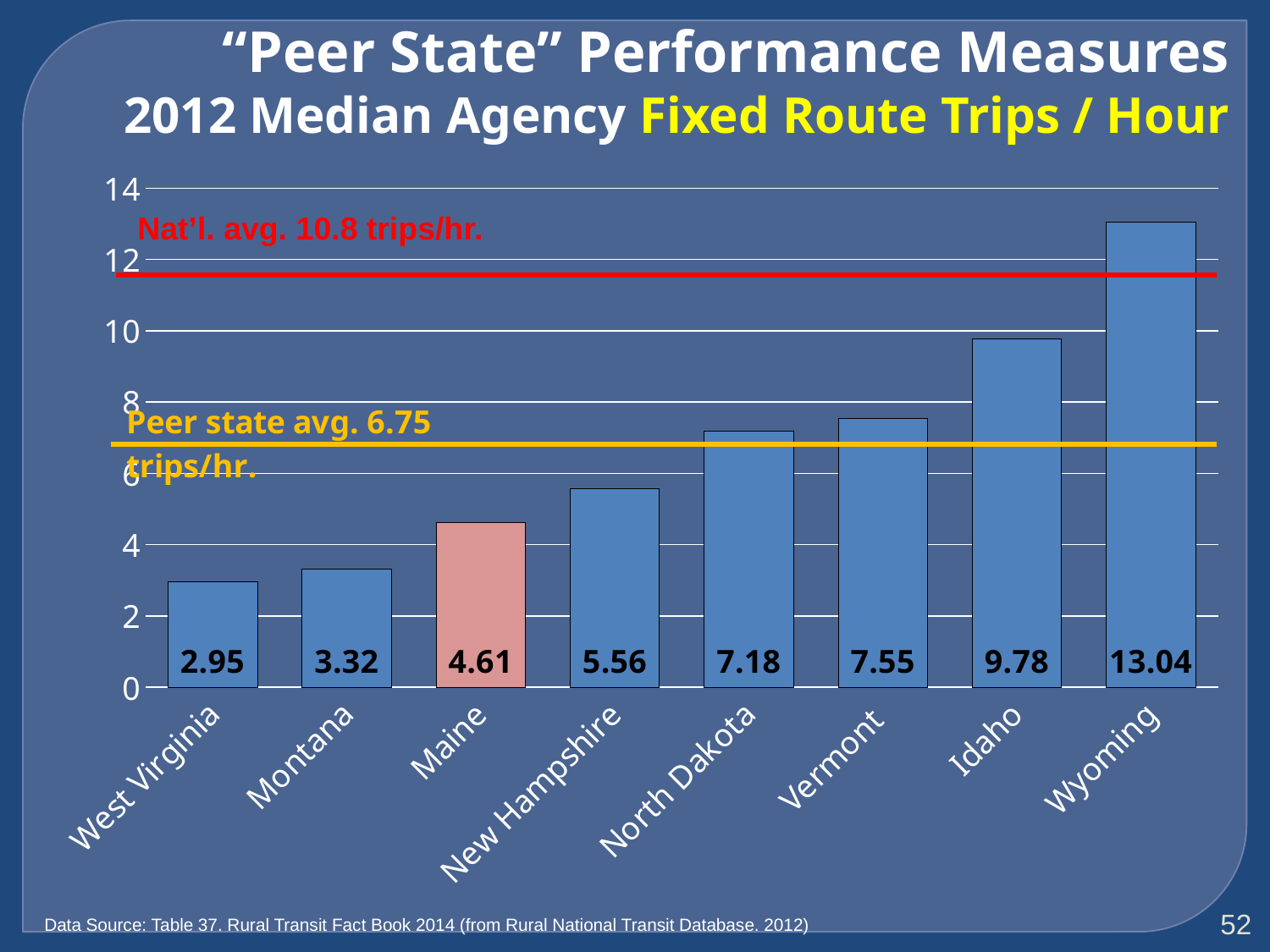
What is the value shown for Idaho? 9.78 What kind of chart is shown on the slide? Bar chart What national average value is labelled on the chart? 10.8 trips/hr. How many states are shown in the chart? 8 Is the value for Idaho greater or less than 8? greater What is the 2012 median agency fixed route trips per hour for Maine? 4.61 What is the difference between Vermont's value and Montana's value? 4.23 Which has a higher value, New Hampshire or Montana? New Hampshire What is the difference between Wyoming's value and Maine's value? 8.43 Which state has the highest fixed route trips per hour? Wyoming Which state has the lowest fixed route trips per hour? West Virginia What is the value shown for North Dakota? 7.18